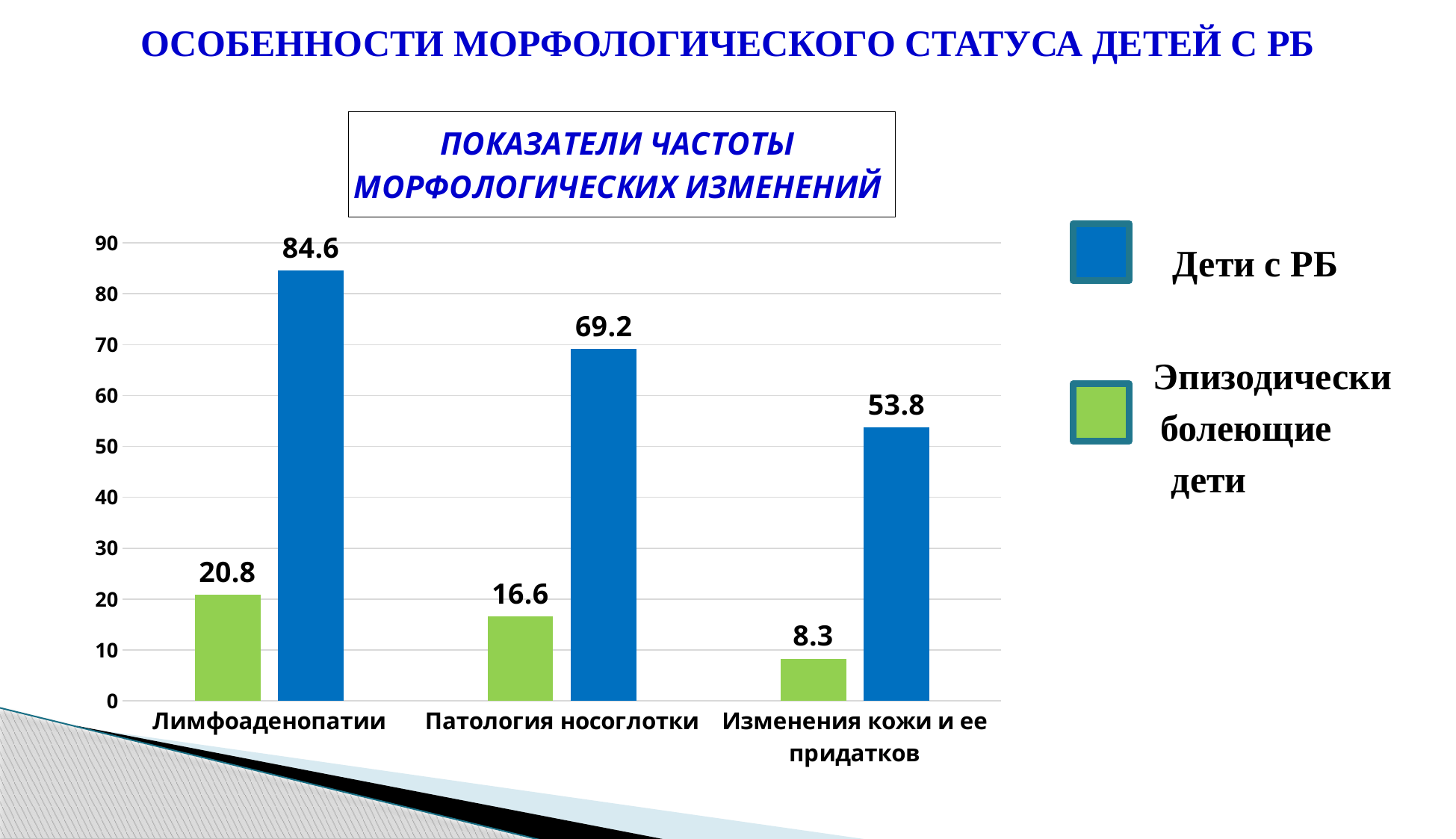
What is the value for Эпизодически болеющие дети in the Изменения кожи и ее придатков category? 8.3 What is the value for Дети с РБ in the Лимфоаденопатии category? 84.6 Which category has the lowest value for Эпизодически болеющие дети? Изменения кожи и ее придатков What kind of chart is shown on the slide? bar chart How many categories are shown on the x axis? 3 What colour represents the Дети с РБ series? blue What is the value for Эпизодически болеющие дети in the Патология носоглотки category? 16.6 Which is larger: the value for Дети с РБ in Изменения кожи и ее придатков or the value for Дети с РБ in Патология носоглотки? Патология носоглотки Is the value for Дети с РБ in Изменения кожи и ее придатков greater or less than 50? greater How many series does the legend list? 2 Which category has the highest value for Дети с РБ? Лимфоаденопатии What is the difference between Дети с РБ and Эпизодически болеющие дети in the Патология носоглотки category? 52.6